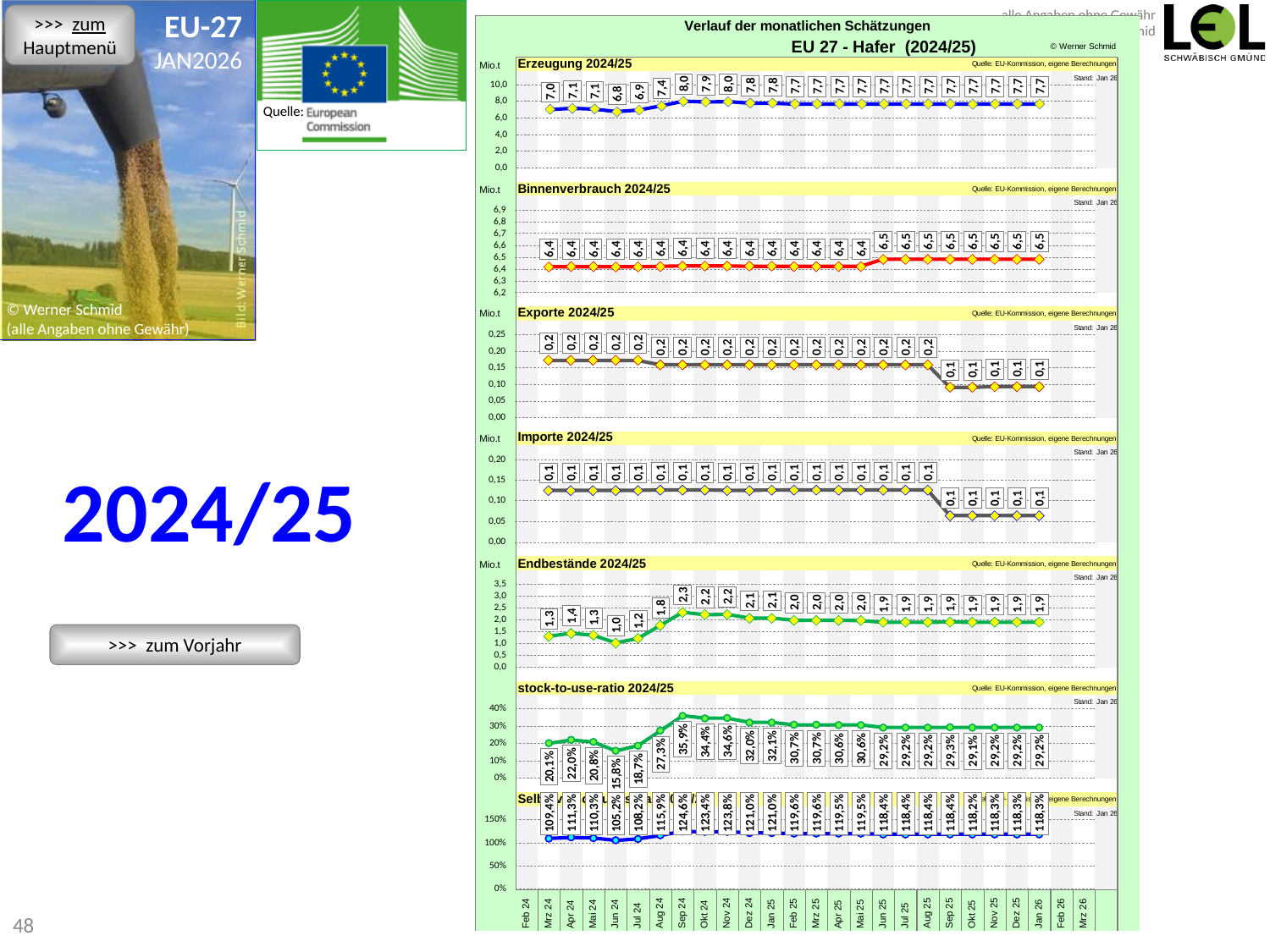
In the Exporte 2024/25 chart, what is the value for Dez 25? 0,1 In the stock-to-use-ratio 2024/25 chart, which month has the lowest value? Jun 24 In the Erzeugung 2024/25 chart, what is the value for Sep 24? 8,0 In the Erzeugung 2024/25 chart, what is the difference between the values for Sep 24 and Mrz 24? 1,0 What kind of chart is the Erzeugung 2024/25 chart? line chart In the Erzeugung 2024/25 chart, what is the value for Jun 24? 6,8 In the Endbestände 2024/25 chart, which month has the lowest value? Jun 24 In the stock-to-use-ratio 2024/25 chart, what is the value for Sep 24? 35,9% In the stock-to-use-ratio 2024/25 chart, is the value for Aug 24 greater or less than the value for Jul 24? greater In the Endbestände 2024/25 chart, which month has the highest value? Sep 24 In the Binnenverbrauch 2024/25 chart, what is the value for Jan 26? 6,5 In the Endbestände 2024/25 chart, what is the value for Jan 26? 1,9